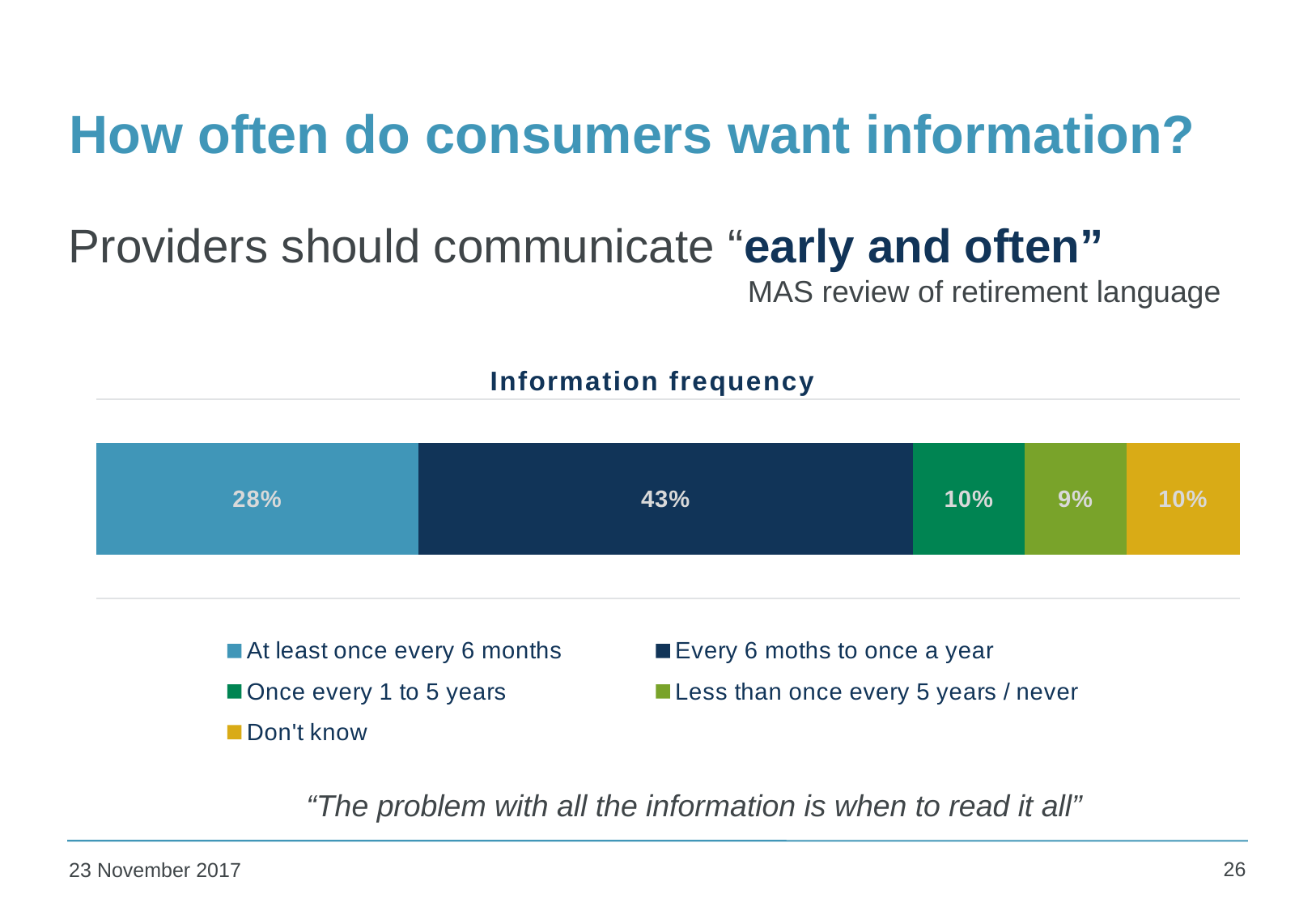
What is the difference between the share for 'Every 6 moths to once a year' and 'At least once every 6 months'? 15% What percentage of consumers want information once every 1 to 5 years? 10% What percentage of consumers want information at least once every 6 months? 28% What is the title of the chart? Information frequency Which information frequency category has the smallest share? Less than once every 5 years / never How many series does the legend list? 5 Which is larger: the share for 'At least once every 6 months' or 'Once every 1 to 5 years'? At least once every 6 months What kind of chart is shown on the slide? Stacked bar chart Which information frequency category has the largest share? Every 6 moths to once a year What percentage of consumers answered 'Don't know'? 10% What percentage of consumers want information less than once every 5 years / never? 9% What percentage of consumers want information every 6 months to once a year? 43%